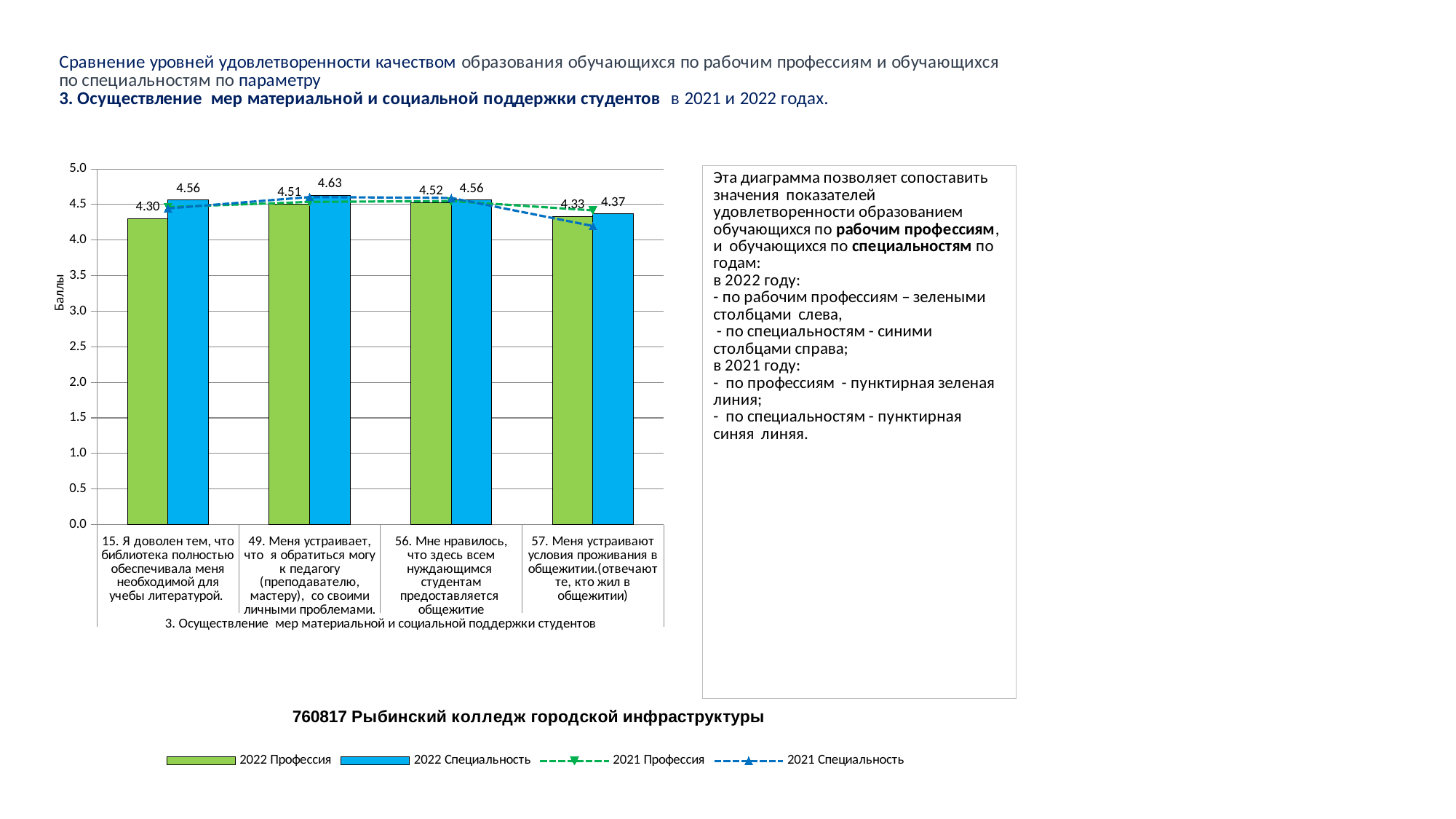
For category 56 (Мне нравилось, что здесь всем нуждающимся студентам предоставляется общежитие), which is larger: the 2022 Профессия bar or the 2022 Специальность bar? 2022 Специальность How many categories are shown on the x axis of the chart? 4 What is the value of the 2022 Профессия bar for category 15 (Я доволен тем, что библиотека полностью обеспечивала меня необходимой для учебы литературой)? 4.30 What is the value of the 2022 Специальность bar for category 57 (Меня устраивают условия проживания в общежитии)? 4.37 What type of chart is used for the 2022 data series? bar chart What is the value of the 2022 Специальность bar for category 49 (Меня устраивает, что я обратиться могу к педагогу)? 4.63 What is the label of the vertical axis of the chart? Баллы Is the 2022 Профессия value for category 57 greater or less than 4.5? less Which category has the lowest 2022 Профессия bar? 15. Я доволен тем, что библиотека полностью обеспечивала меня необходимой для учебы литературой. Which category has the highest 2022 Специальность bar? 49. Меня устраивает, что я обратиться могу к педагогу (преподавателю, мастеру), со своими личными проблемами. What is the difference between the 2022 Специальность and 2022 Профессия values for category 15? 0.26 How many series does the chart legend list? 4